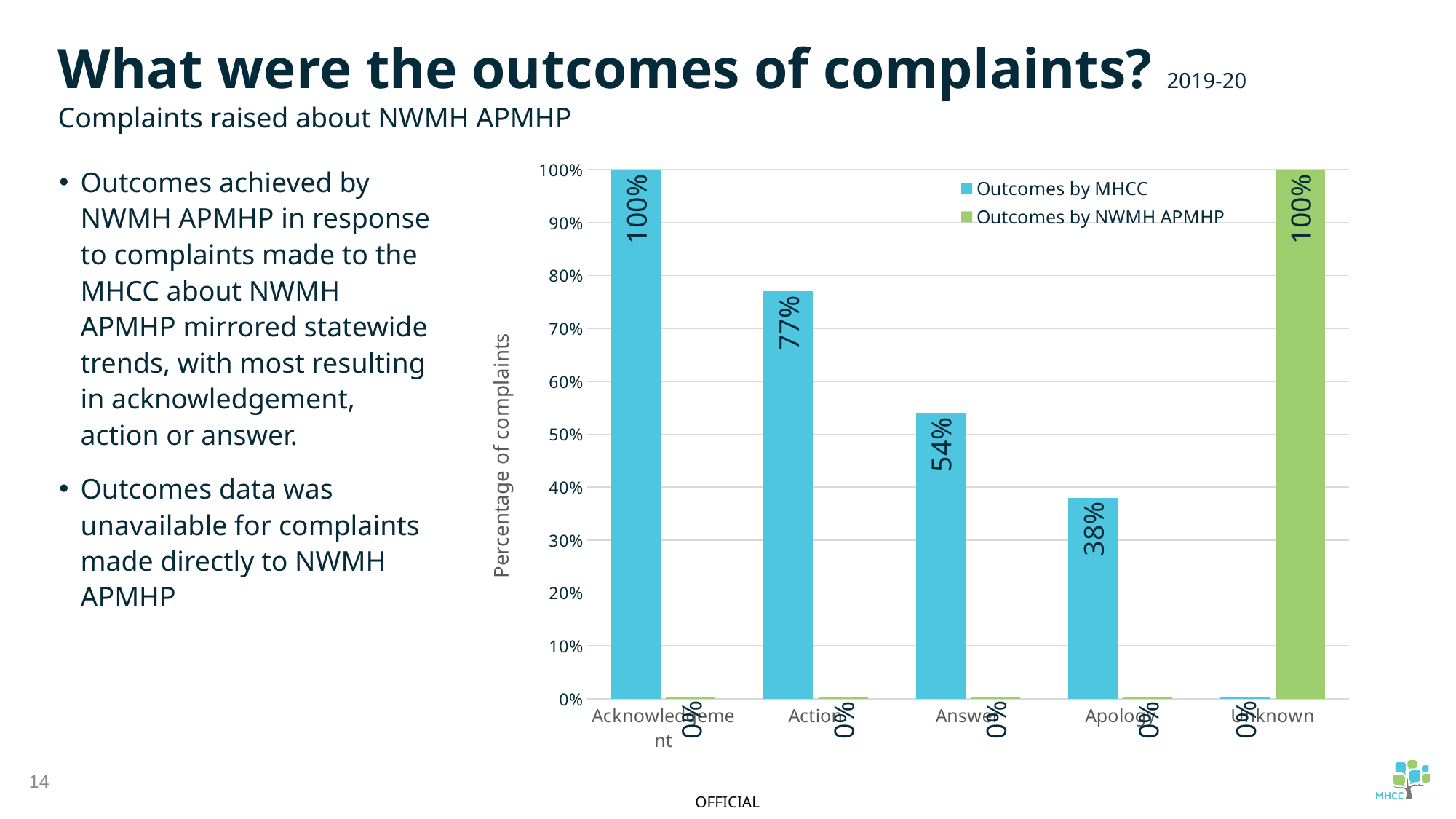
What is the value for Acknowledgement in the Outcomes by NWMH APMHP series? 0% What is the value for Answer in the Outcomes by MHCC series? 54% How many categories are shown on the x axis? 5 What is the value for Apology in the Outcomes by MHCC series? 38% What is the difference between the Outcomes by MHCC values for Action and Apology? 39% What kind of chart is shown on the slide? Bar chart How many series does the legend list? 2 Which category has the lowest value in the Outcomes by MHCC series? Unknown What is the value for Unknown in the Outcomes by NWMH APMHP series? 100% Which category has the highest value in the Outcomes by MHCC series? Acknowledgement What is the value for Action in the Outcomes by MHCC series? 77% In the Outcomes by MHCC series, which is larger: Answer or Apology? Answer